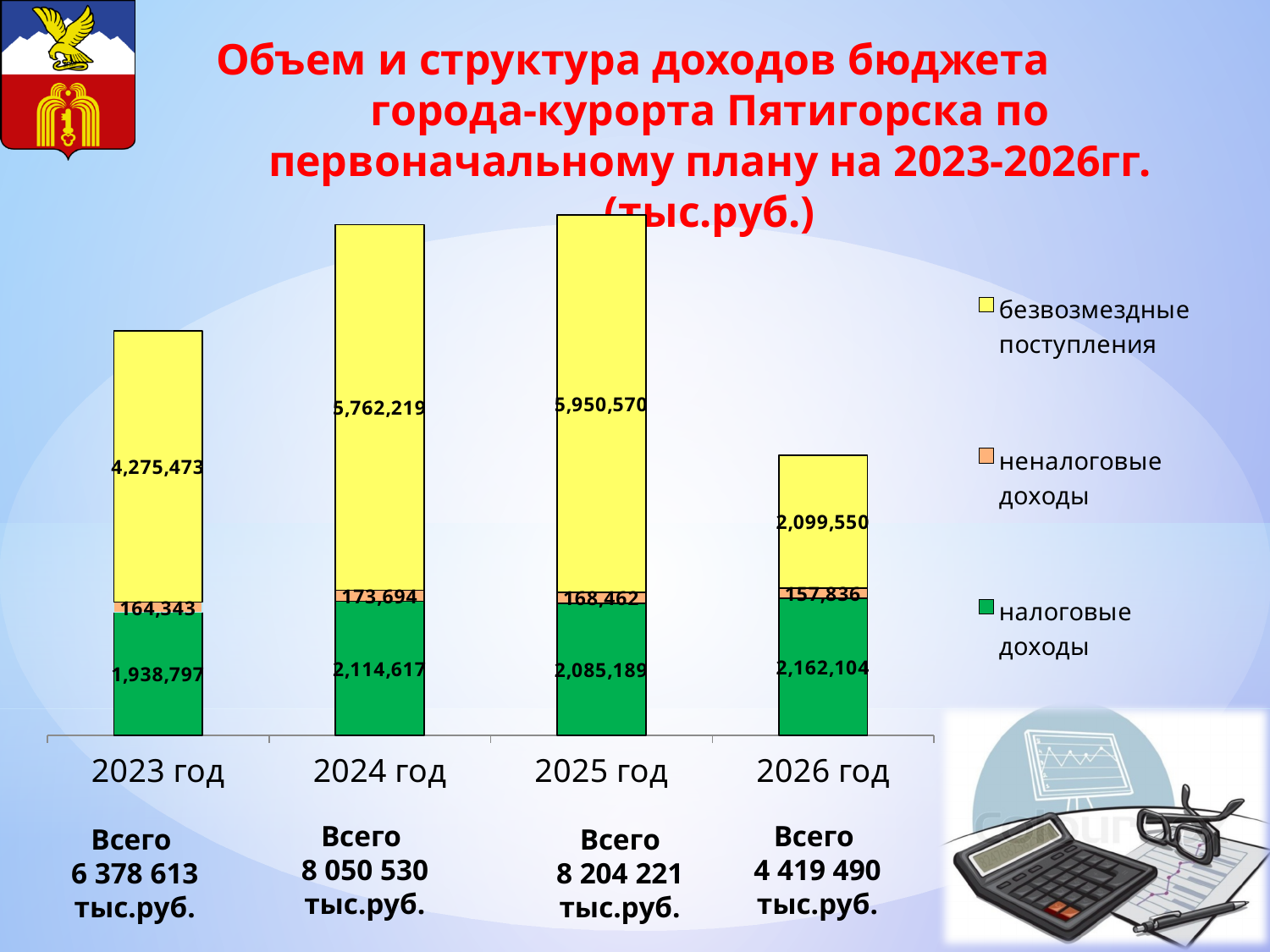
How many series does the legend list? 3 In which year is the value of безвозмездные поступления the highest? 2025 год In which year is the value of неналоговые доходы the lowest? 2026 год What is the value of безвозмездные поступления for 2025 год? 5,950,570 What is the difference between безвозмездные поступления in 2025 год and 2024 год? 188,351 Which year has the larger value of налоговые доходы, 2024 год or 2025 год? 2024 год How many years (categories) are shown on the x axis? 4 In which year is the value of налоговые доходы the highest? 2026 год What is the total of the stacked bar for 2023 год? 6 378 613 тыс.руб. What is the value of неналоговые доходы for 2024 год? 173,694 What is the value of налоговые доходы for 2023 год? 1,938,797 What kind of chart is shown on the slide? Stacked bar chart